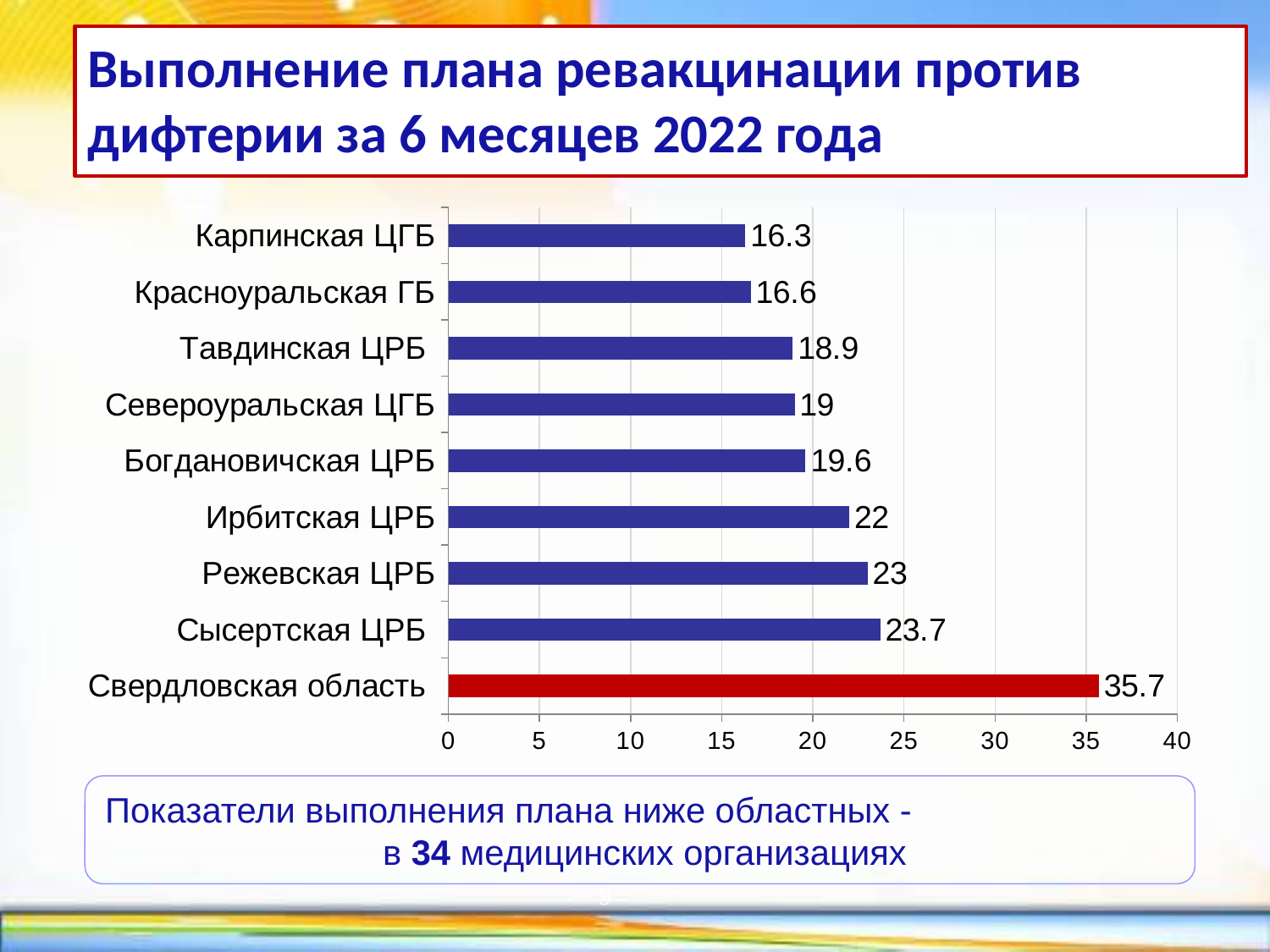
What is the value for Свердловская область? 35.7 What is the value for Режевская ЦРБ? 23 Which is larger, the value for Богдановичская ЦРБ or the value for Североуральская ЦГБ? Богдановичская ЦРБ What is the difference between the values for Свердловская область and Сысертская ЦРБ? 12 What is the value for Тавдинская ЦРБ? 18.9 Which category has the lowest value? Карпинская ЦГБ What is the difference between the values for Ирбитская ЦРБ and Карпинская ЦГБ? 5.7 Which bar is coloured red rather than blue? Свердловская область What kind of chart is shown on the slide? bar chart Is the value for Красноуральская ГБ greater or less than 20? less Which category has the highest value? Свердловская область How many categories are shown in the chart? 9